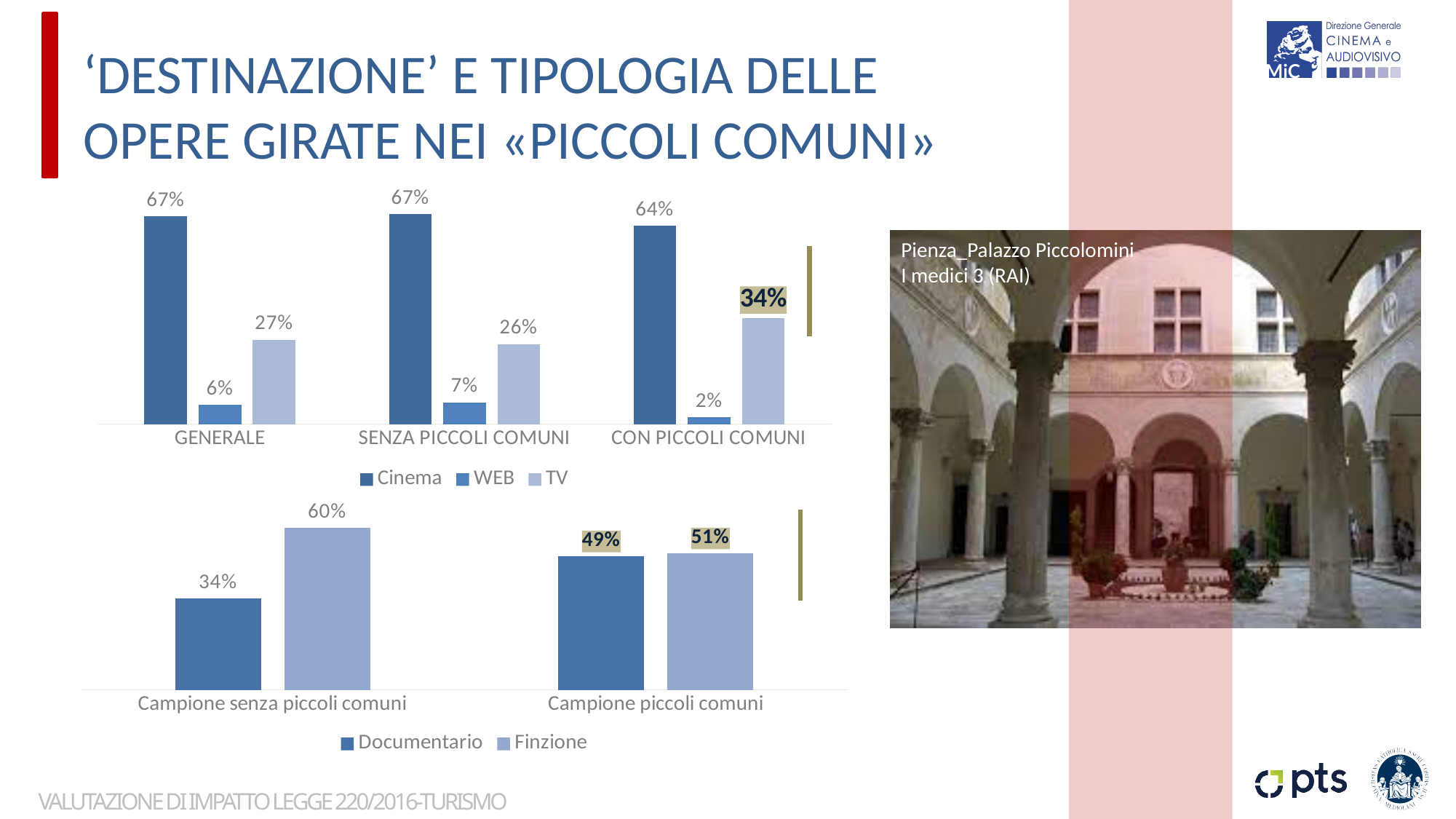
In the bottom chart, what is the difference between Finzione and Documentario in the Campione senza piccoli comuni category? 26% In the top chart, how many series does the legend list? 3 In the top chart, which category has the lowest WEB value? CON PICCOLI COMUNI In the bottom chart, which series does the legend list first? Documentario In the top chart, what is the value for TV in the CON PICCOLI COMUNI category? 34% In the top chart, what is the value for Cinema in the SENZA PICCOLI COMUNI category? 67% In the bottom chart, what is the value for Documentario in the Campione piccoli comuni category? 49% In the top chart, how many categories are shown on the x axis? 3 In the bottom chart, what is the value for Finzione in the Campione senza piccoli comuni category? 60% In the top chart, what is the value for WEB in the GENERALE category? 6% What kind of chart is the bottom chart? Bar chart In the top chart, what is the difference between the TV values for CON PICCOLI COMUNI and SENZA PICCOLI COMUNI? 8%